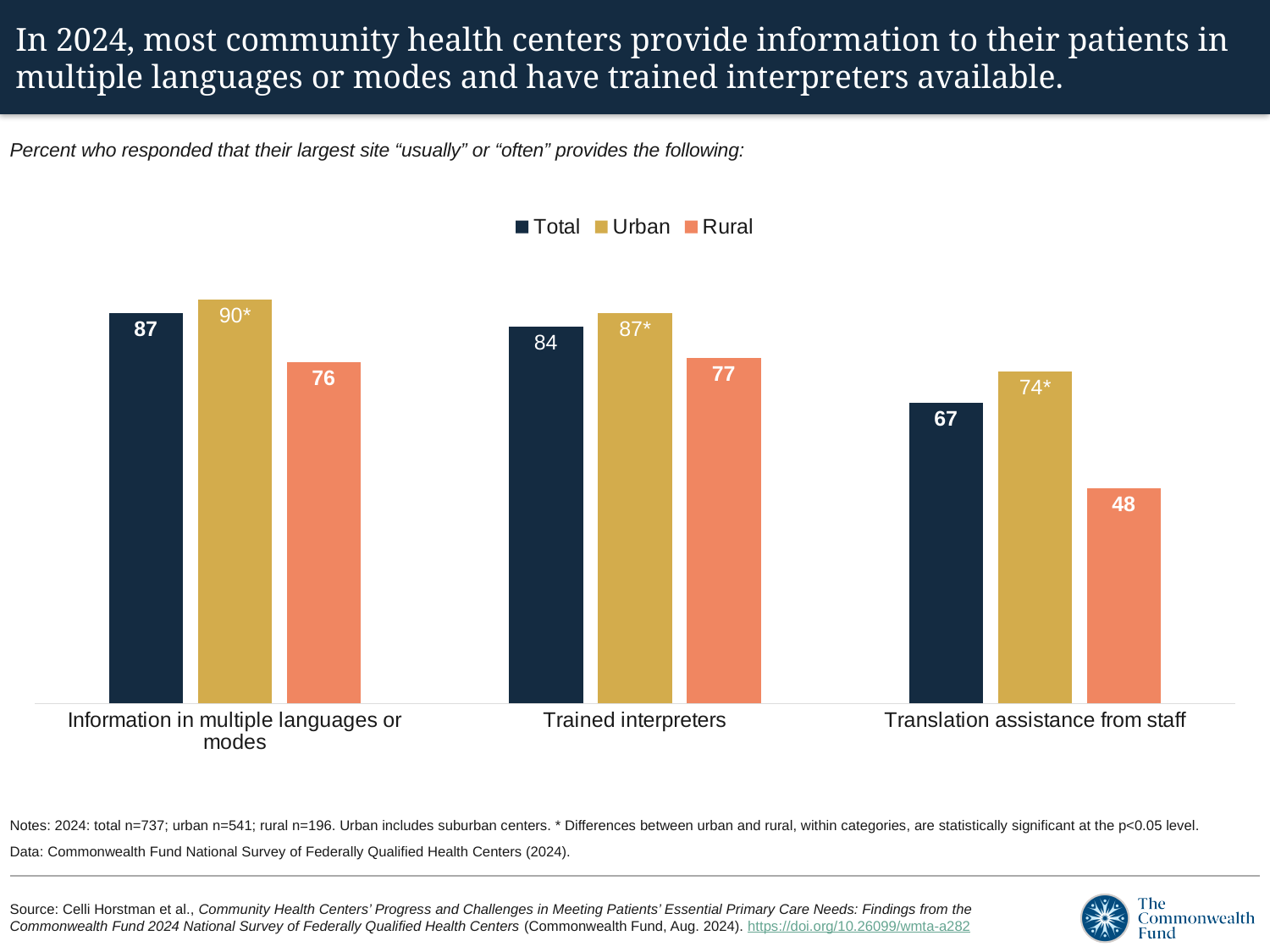
How many categories are shown on the x axis? 3 What kind of chart is shown on the slide? Bar chart Which category has the highest Urban value? Information in multiple languages or modes What is the Total value for Trained interpreters? 84 What is the Urban value for Information in multiple languages or modes? 90* What is the difference between the Total values for Information in multiple languages or modes and Translation assistance from staff? 20 Which series is shown in orange in the legend? Rural What is the difference between the Urban and Rural values for Translation assistance from staff? 26 Which category has the lowest Rural value? Translation assistance from staff What is the Rural value for Translation assistance from staff? 48 How many series does the legend list? 3 Which is larger for Trained interpreters: the Urban value or the Rural value? Urban